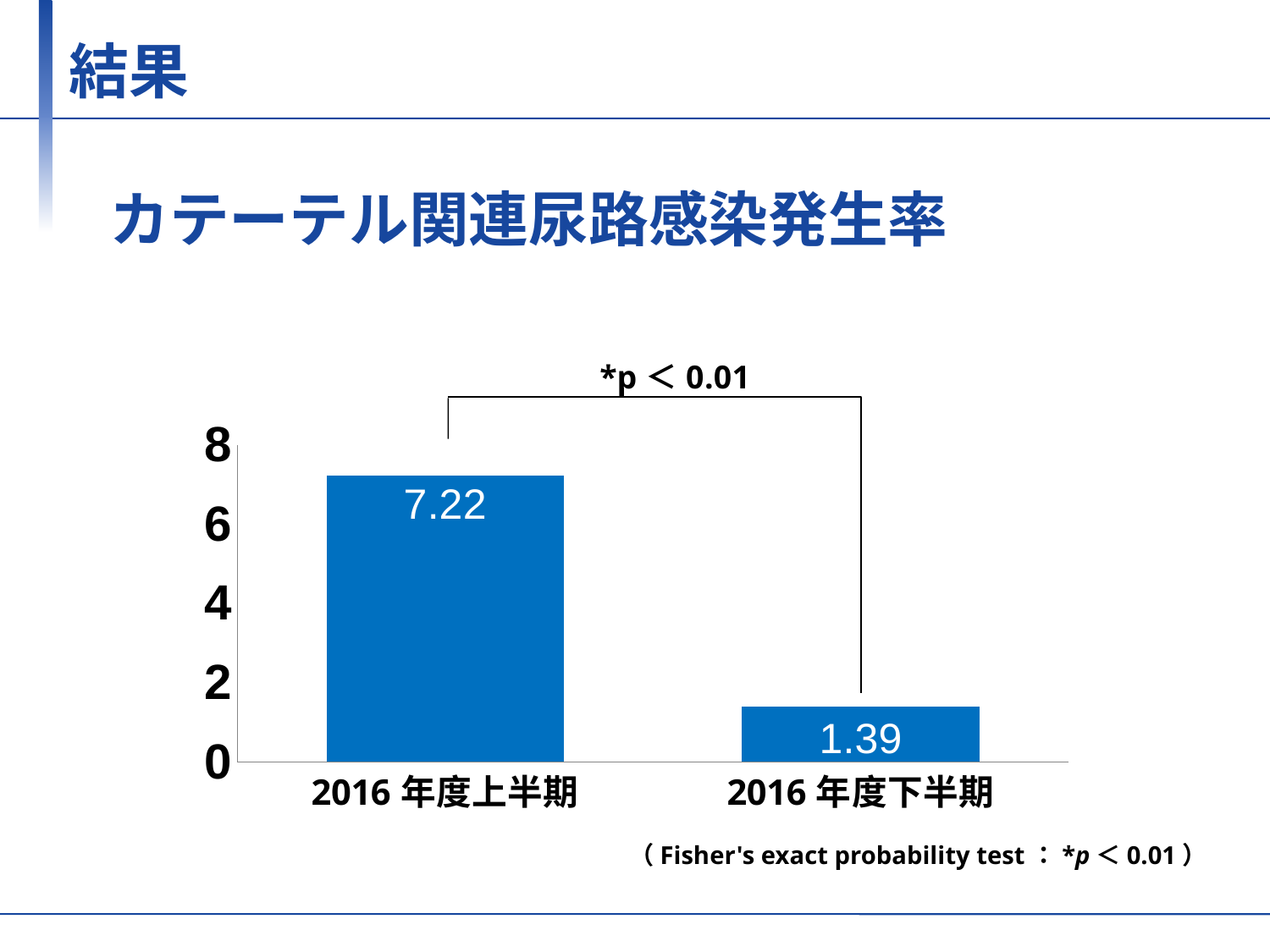
Which is larger, the value for 2016 年度上半期 or 2016 年度下半期? 2016 年度上半期 What is the value for 2016 年度下半期? 1.39 Which category has the lowest value? 2016 年度下半期 What is the title of the chart? カテーテル関連尿路感染発生率 What is the difference between the values for 2016 年度上半期 and 2016 年度下半期? 5.83 Is the value for 2016 年度下半期 greater or less than 2? less What kind of chart is shown on the slide? bar chart Do the values rise or fall from 2016 年度上半期 to 2016 年度下半期? fall What is the value for 2016 年度上半期? 7.22 How many categories are shown on the x axis? 2 Is the value for 2016 年度上半期 greater or less than 6? greater Which category has the highest value? 2016 年度上半期